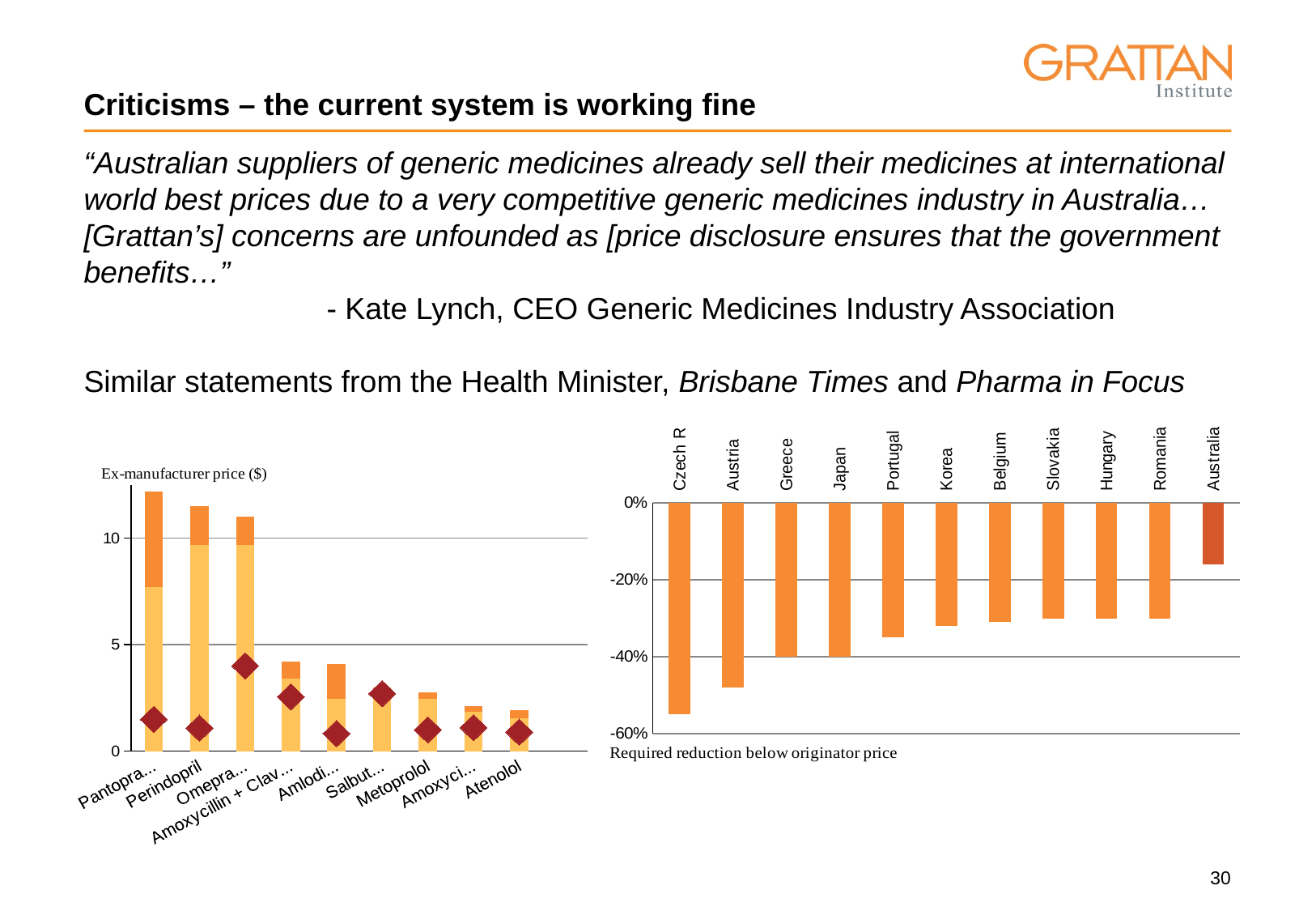
In the right-hand chart (Required reduction below originator price), which country has the largest reduction (the lowest value)? Czech R In the left-hand chart (Ex-manufacturer price ($)), is the total bar for Atenolol greater or less than 5? less In the left-hand chart (Ex-manufacturer price ($)), how many medicines are shown on the x axis? 9 In the right-hand chart (Required reduction below originator price), is the value for Portugal greater or less than -40%? greater In the right-hand chart (Required reduction below originator price), is the value for Australia greater or less than -20%? greater In the right-hand chart (Required reduction below originator price), how many countries are shown? 11 In the right-hand chart (Required reduction below originator price), which country has the smallest reduction (the value closest to 0%)? Australia What kind of chart is the right-hand chart titled 'Required reduction below originator price'? bar chart In the left-hand chart (Ex-manufacturer price ($)), which medicine has the tallest bar? Pantopra... In the left-hand chart (Ex-manufacturer price ($)), do the bar heights rise or fall from left to right? fall In the right-hand chart (Required reduction below originator price), which has the larger reduction, Austria or Australia? Austria